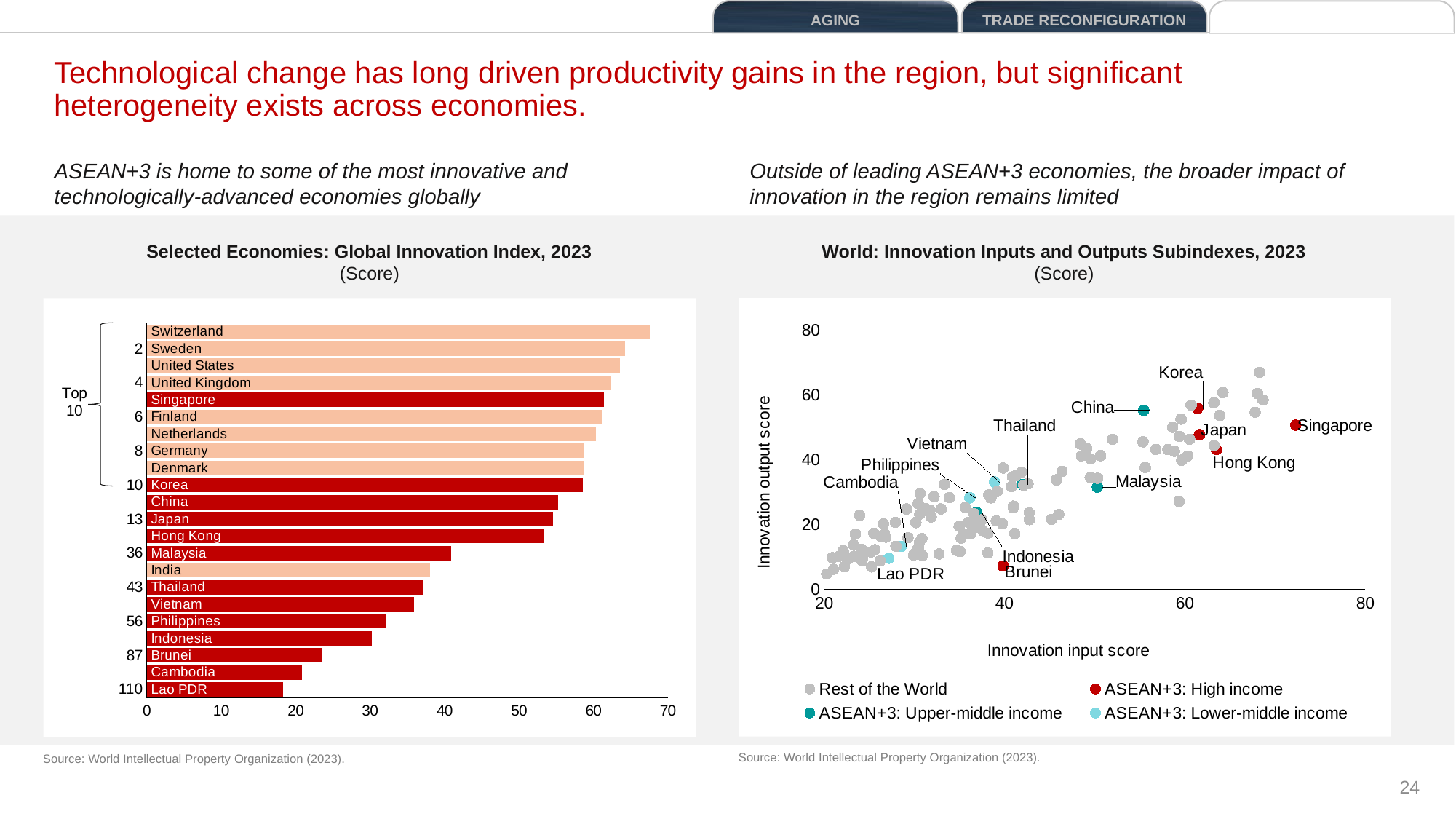
In the left chart, 'Selected Economies: Global Innovation Index, 2023', is the value for Malaysia greater or less than 50? less In the left chart, 'Selected Economies: Global Innovation Index, 2023', which economy has the highest score? Switzerland In the right chart, 'World: Innovation Inputs and Outputs Subindexes, 2023', is the innovation output score for Lao PDR greater or less than 20? less What kind of chart is the right chart, 'World: Innovation Inputs and Outputs Subindexes, 2023'? Scatter chart In the right chart, 'World: Innovation Inputs and Outputs Subindexes, 2023', is the innovation input score for Singapore greater or less than 60? greater In the left chart, 'Selected Economies: Global Innovation Index, 2023', which has the higher score, China or Malaysia? China How many series does the legend of the right chart, 'World: Innovation Inputs and Outputs Subindexes, 2023', list? 4 What kind of chart is the left chart, 'Selected Economies: Global Innovation Index, 2023'? Bar chart In the left chart, 'Selected Economies: Global Innovation Index, 2023', which economy has the lowest score? Lao PDR How many economies are shown in the left chart, 'Selected Economies: Global Innovation Index, 2023'? 22